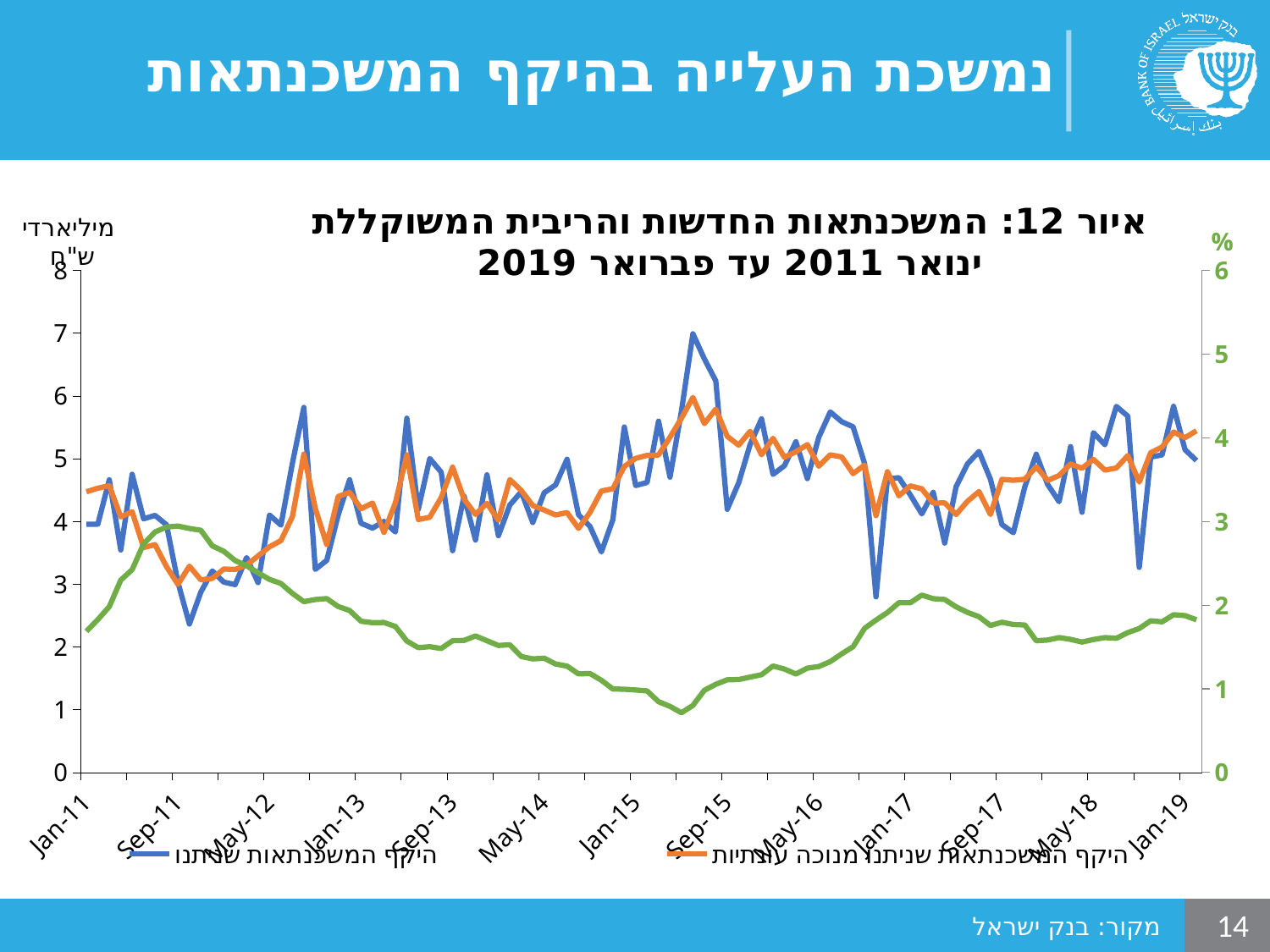
In which year does the green line reach its lowest point? 2015 Is the value of the orange line (היקף המשכנתאות שניתנו מנוכה עונתיות) at Jan-11 greater or less than 4 on the left axis? greater Does the orange line (היקף המשכנתאות שניתנו מנוכה עונתיות) generally rise or fall from Jan-12 to Sep-15? rise Is the value of the green line at Jan-11 greater or less than 2 on the right axis? less Does the green line rise or fall between Sep-11 and Jan-15? fall What unit is shown on the left vertical axis of the chart? מיליארדי ש"ח What is the title of the chart? איור 12: המשכנתאות החדשות והריבית המשוקללת ינואר 2011 עד פברואר 2019 Is the peak value of the blue line (היקף המשכנתאות שניתנו) in 2015 greater or less than 6 on the left axis? greater What kind of chart is shown on the slide? line chart In which year does the blue line (היקף המשכנתאות שניתנו) reach its highest point? 2015